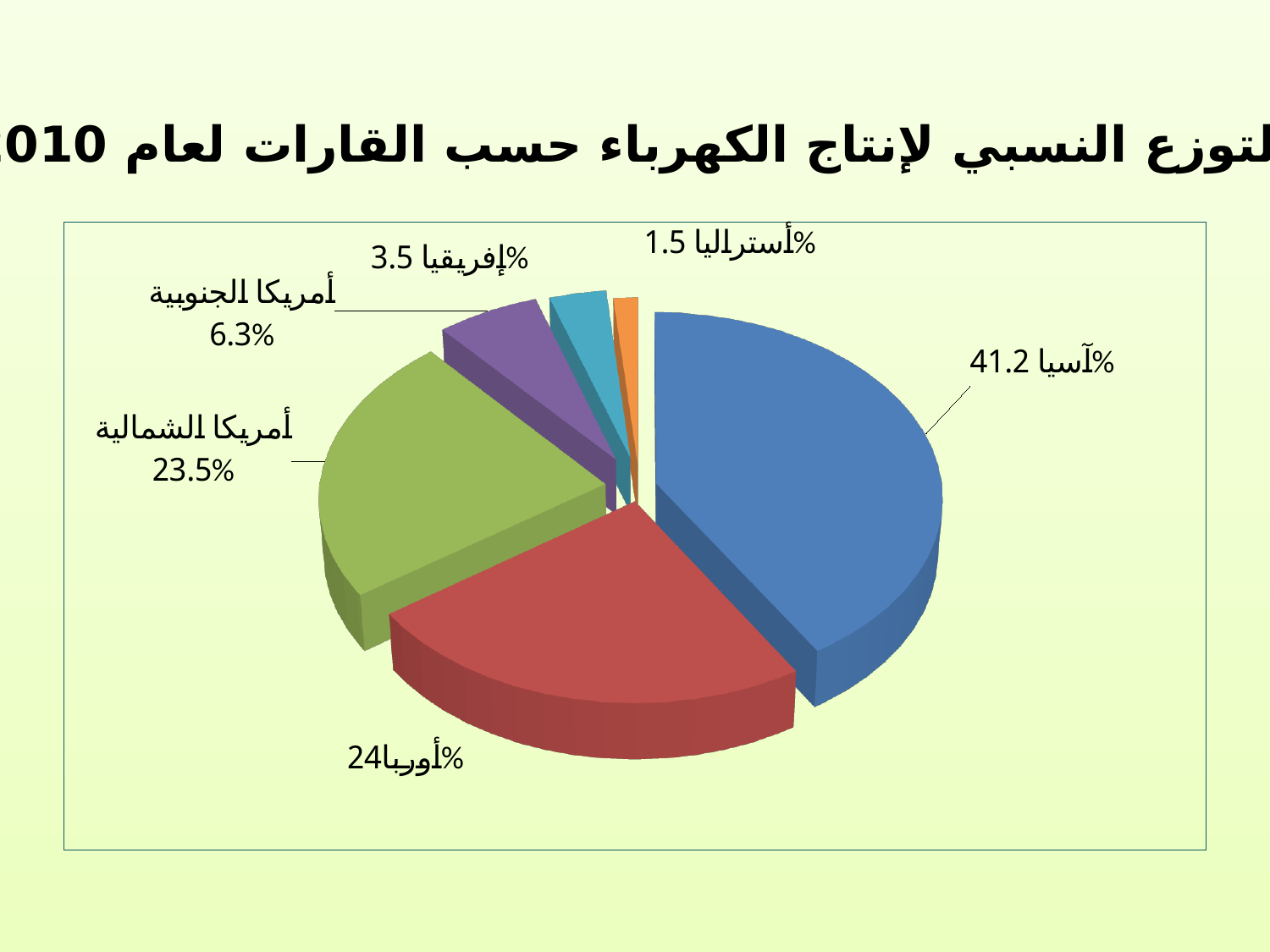
What value is labelled for أمريكا الشمالية (North America)? 23.5% What percentage is shown for أمريكا الجنوبية (South America)? 6.3% Which has a larger share, أمريكا الجنوبية (South America) or إفريقيا (Africa)? أمريكا الجنوبية (South America) Which continent has the largest share of electricity production in the chart? آسيا (Asia) What is the share shown for أوروبا (Europe)? 24% What percentage is shown for أستراليا (Australia)? 1.5% What type of chart is shown on the slide? Pie chart Which continent has the smallest share in the chart? أستراليا (Australia) What percentage of electricity production does آسيا (Asia) account for in the pie chart? 41.2% How many continents (slices) are shown in the pie chart? 6 What is the difference between the shares of آسيا (Asia) and أوروبا (Europe)? 17.2% What is the share labelled for إفريقيا (Africa)? 3.5%